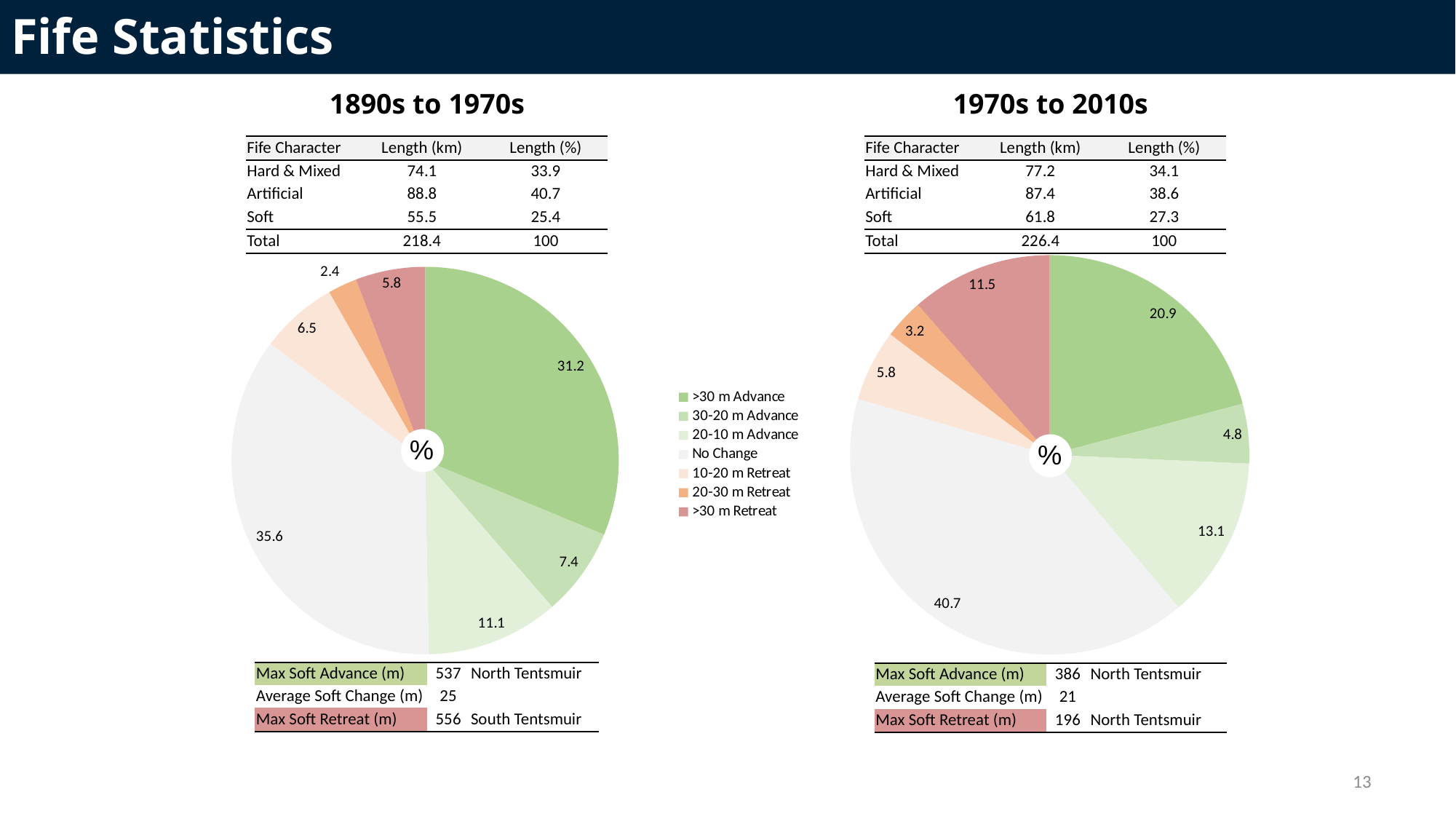
Which legend entry is shown in red? >30 m Retreat In the 1890s to 1970s pie chart, what is the value for No Change? 35.6 In the 1970s to 2010s pie chart, what is the value for >30 m Retreat? 11.5 In the 1970s to 2010s pie chart, which category has the largest slice? No Change How many categories does the legend list for the pie charts? 7 In the 1890s to 1970s pie chart, what is the difference between the 10-20 m Retreat value and the 20-30 m Retreat value? 4.1 In the 1890s to 1970s pie chart, which category has the smallest slice? 20-30 m Retreat In the 1890s to 1970s pie chart, what is the value for >30 m Advance? 31.2 In the 1970s to 2010s pie chart, what is the value for 20-10 m Advance? 13.1 In the 1890s to 1970s pie chart, which is larger: 30-20 m Advance or 20-10 m Advance? 20-10 m Advance What type of chart is used for the 1890s to 1970s data? Pie chart In the 1970s to 2010s pie chart, what is the difference between the No Change value and the >30 m Advance value? 19.8